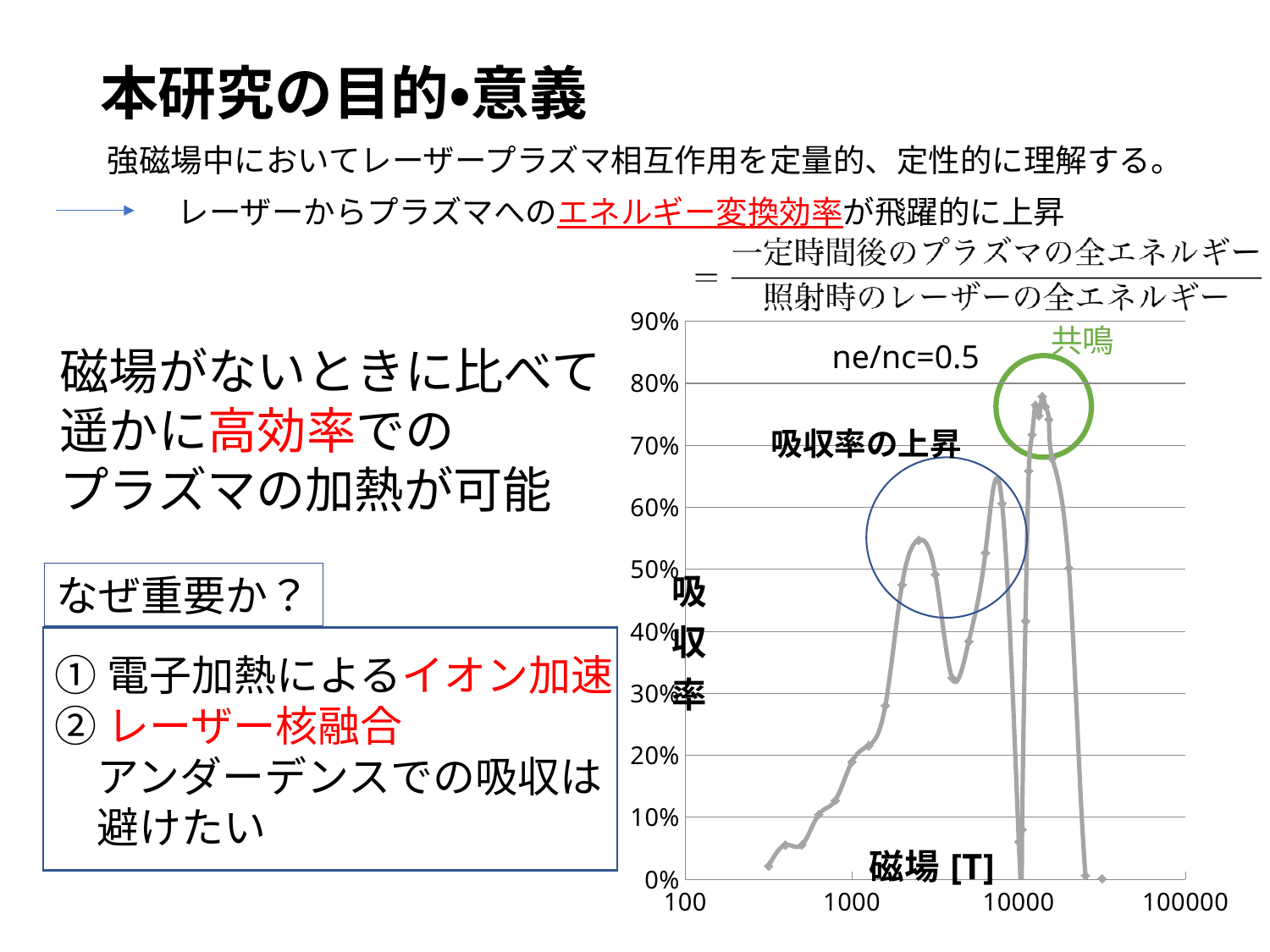
What is the label of the y axis of the chart? 吸収率 What is the highest tick value shown on the x axis of the chart? 100000 What is the label of the x axis of the chart? 磁場 [T] What density ratio is annotated on the chart? ne/nc=0.5 Is the absorption rate at the first local peak (around 2500 T) greater or less than 50%? greater Is the absorption rate at the dip between the first two peaks (around 4000 T) greater or less than 40%? less Does the absorption rate rise or fall as the magnetic field increases from 300 T to 2000 T? rise What kind of chart is shown on the slide? line chart